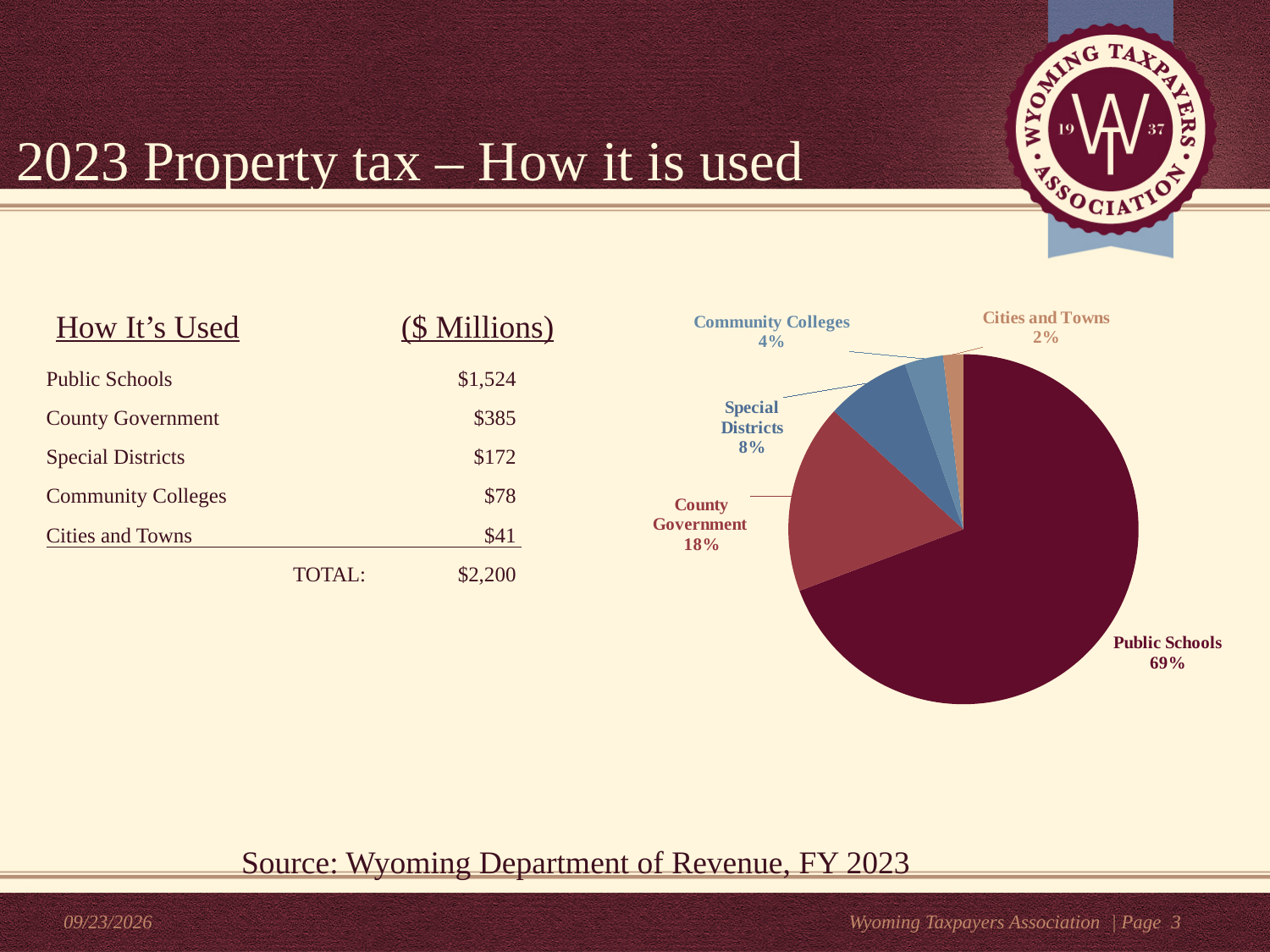
Which slice is larger in the pie chart, Special Districts or Community Colleges? Special Districts How many slices does the pie chart have? 5 What percentage is shown for County Government in the pie chart? 18% Which category has the largest slice of the pie chart? Public Schools What is the difference in percentage points between the Public Schools slice and the County Government slice? 51 What colour is the Public Schools slice in the pie chart? Dark maroon What percentage is shown for Cities and Towns in the pie chart? 2% What share of the pie chart does Public Schools represent? 69% Which category has the smallest slice of the pie chart? Cities and Towns What percentage is shown for Community Colleges in the pie chart? 4% What percentage is shown for Special Districts in the pie chart? 8% What kind of chart is shown on the slide? Pie chart